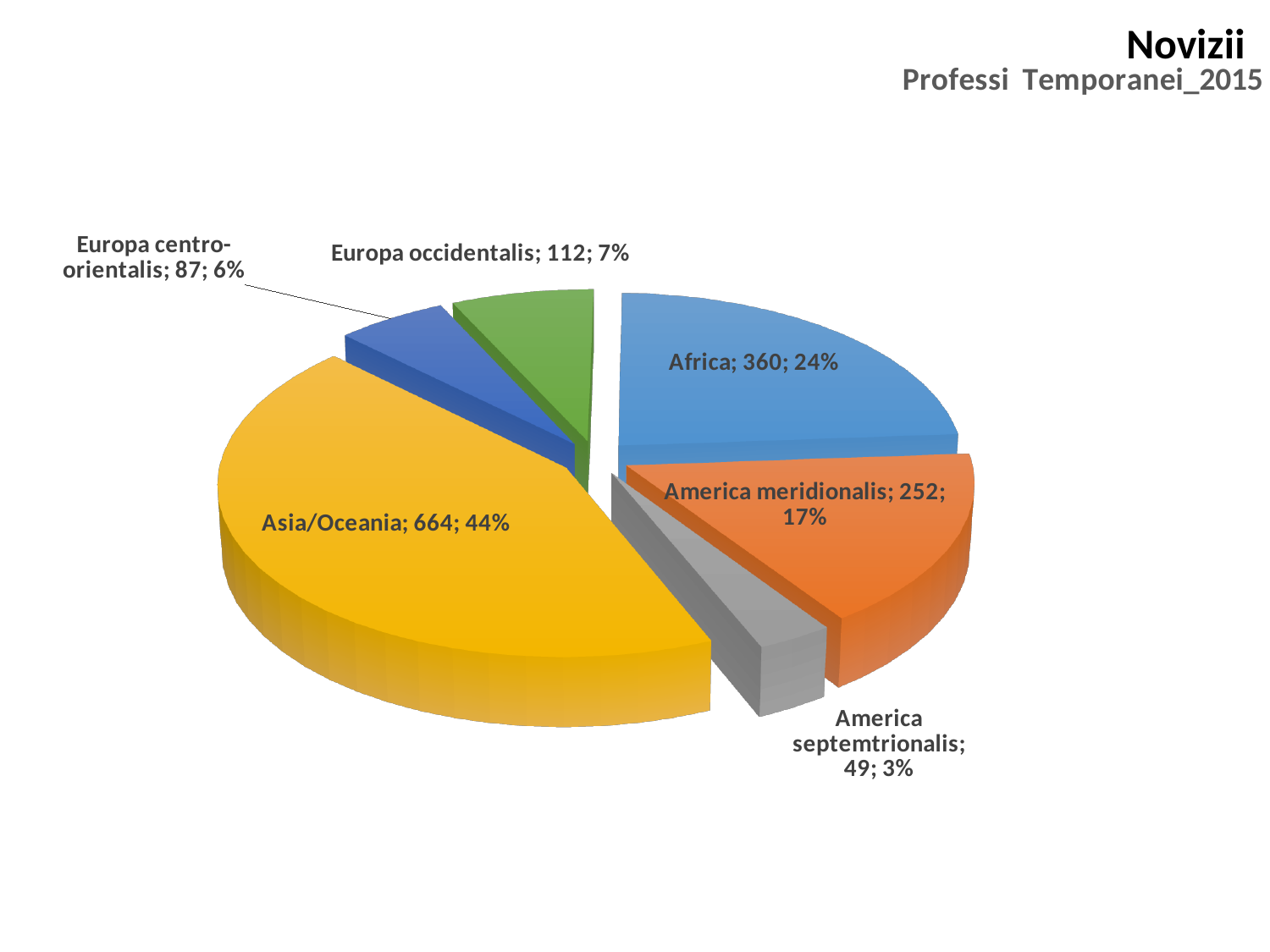
What is the value for America meridionalis? 252 How many categories are shown in the pie chart? 6 What share of the pie does Europa occidentalis represent? 7% What is the title of the chart? Professi Temporanei_2015 What share of the pie does Asia/Oceania represent? 44% What kind of chart is shown on the slide? pie chart What is the value for Europa centro-orientalis? 87 What is the value for Africa? 360 Which category has the largest slice? Asia/Oceania What is the difference between the values for Africa and America meridionalis? 108 Which category has the smallest slice? America septemtrionalis Which is larger, the value for Europa occidentalis or Europa centro-orientalis? Europa occidentalis